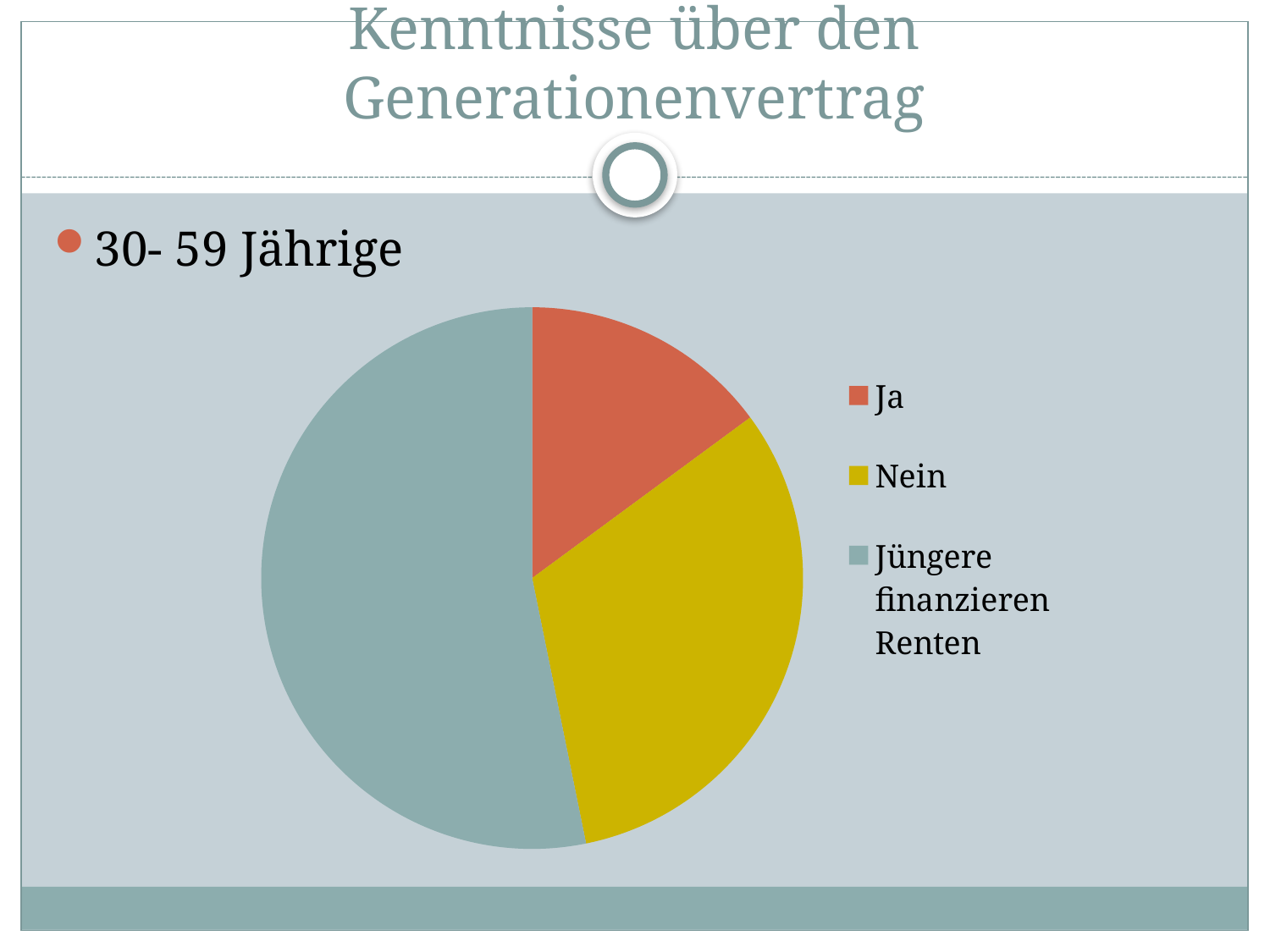
Which slice is larger, Nein or Jüngere finanzieren Renten? Jüngere finanzieren Renten Which category has the largest slice in the pie chart? Jüngere finanzieren Renten Which slice is larger, Ja or Nein? Nein Which category has the smallest slice in the pie chart? Ja How many slices does the pie chart have? 3 What kind of chart is shown on the slide? pie chart How many entries does the legend of the pie chart list? 3 Which age group does the pie chart refer to, according to the text above it? 30- 59 Jährige What colour is the slice for Nein in the pie chart? yellow